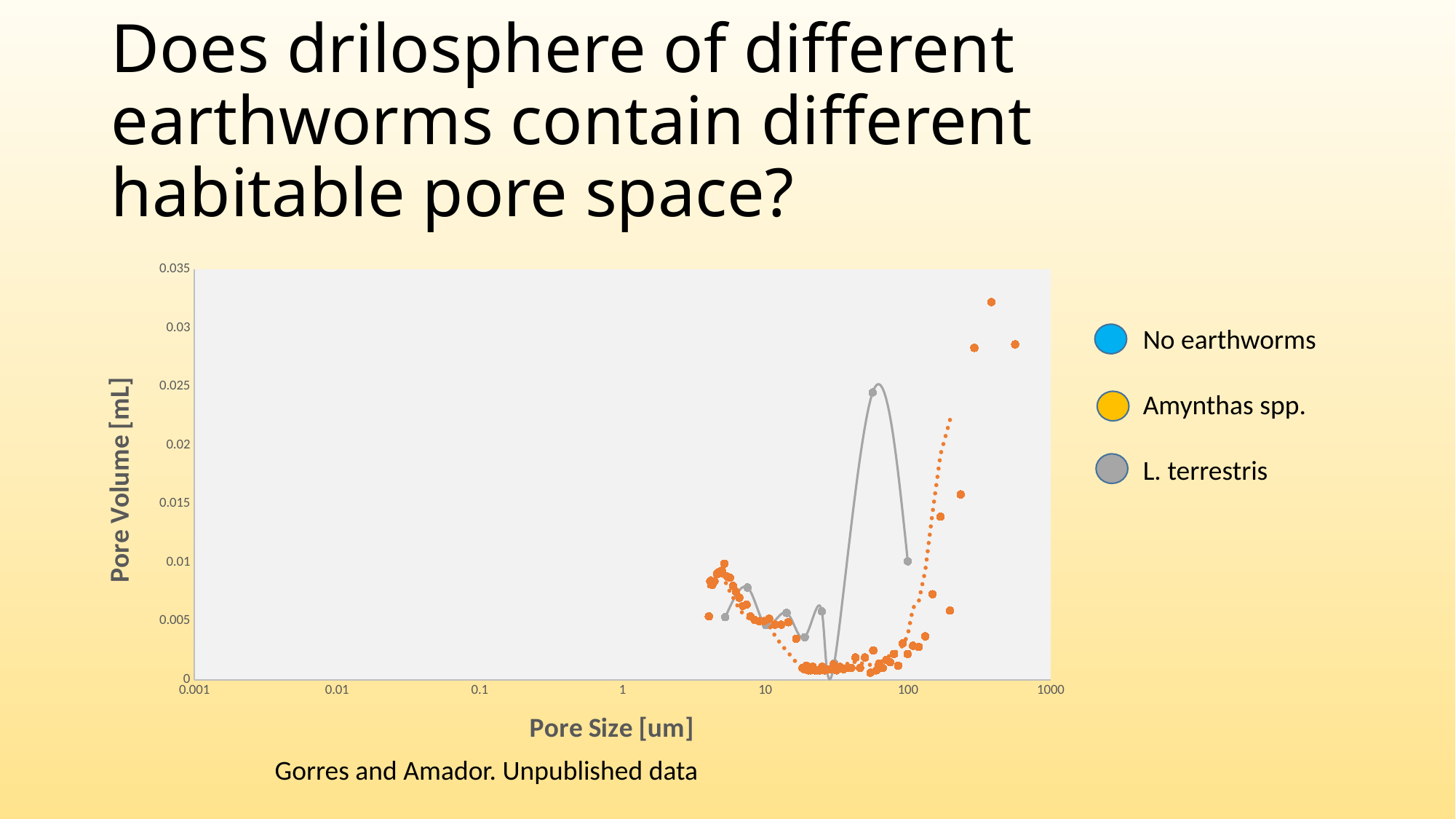
Do the L. terrestris values rise or fall as pore size increases from about 60 um to 100 um? fall What colour is used for the L. terrestris series in the legend? gray Is the L. terrestris point at a pore size of 100 um greater or less than 0.015 mL? less Which series reaches the highest pore volume on the chart? Amynthas spp. What kind of chart is shown on the slide? scatter chart How many series does the chart legend list? 3 At a pore size of about 60 um, which series has the higher pore volume, Amynthas spp. or L. terrestris? L. terrestris Is the highest Amynthas spp. point greater or less than 0.03 mL? greater What is the title of the x axis of the chart? Pore Size [um] Is the peak of the L. terrestris series greater or less than 0.02 mL? greater Do the Amynthas spp. values rise or fall as pore size increases from 100 um to 1000 um? rise